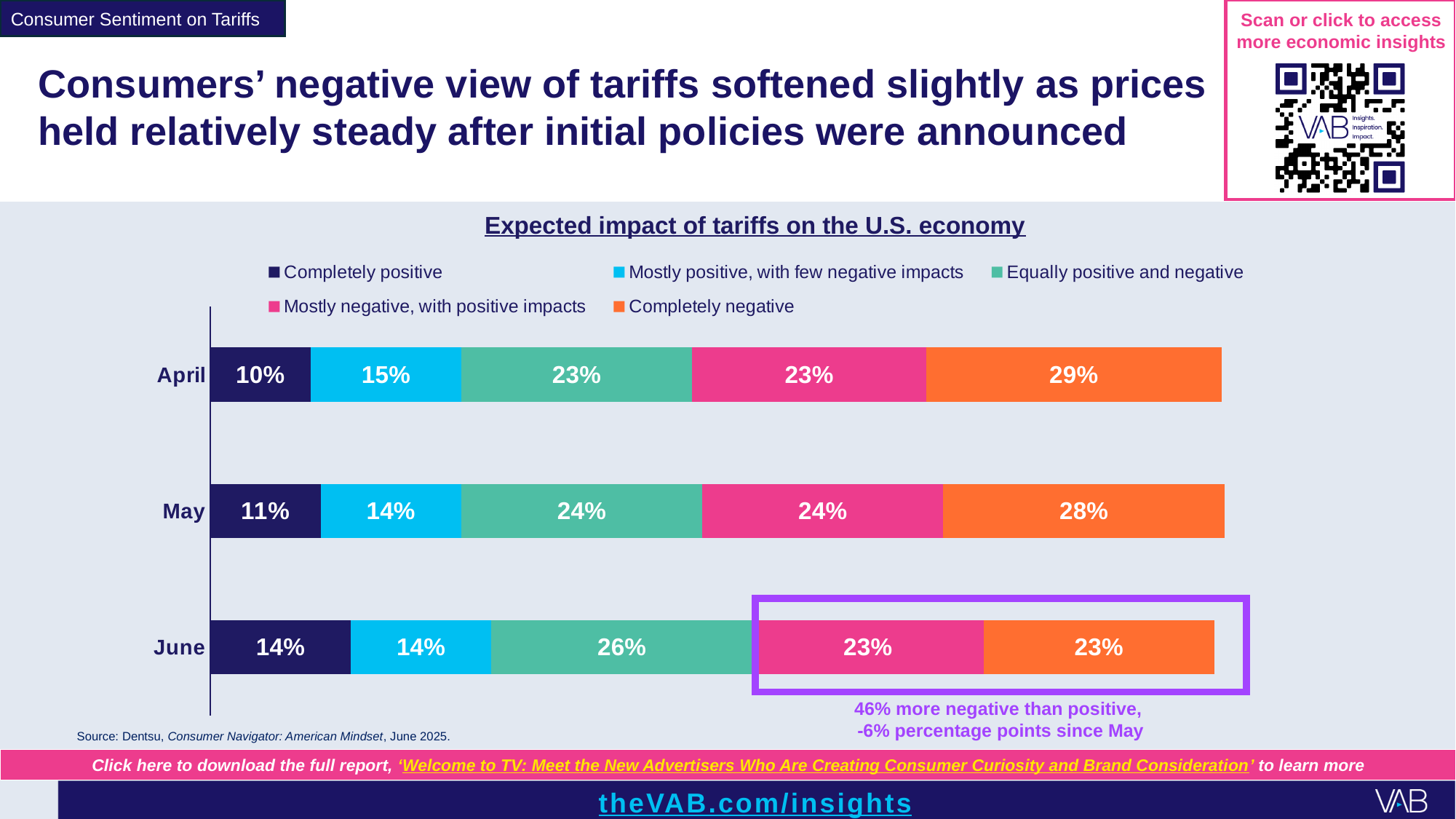
What is the title of the chart? Expected impact of tariffs on the U.S. economy Does the 'Completely positive' value rise or fall from April to June? Rises Which month has the highest value for 'Completely negative'? April How many months are shown in the chart? 3 What kind of chart is shown on the slide? Stacked bar chart Which month has the lowest value for 'Completely positive'? April What percentage of consumers expected a completely negative impact of tariffs in April? 29% What is the value for 'Equally positive and negative' in May? 24% Which month has the larger value for 'Mostly positive, with few negative impacts': April or June? April By how many percentage points did 'Completely negative' fall from April to June? 6 percentage points What is the value for 'Completely positive' in June? 14% How many series does the legend list? 5